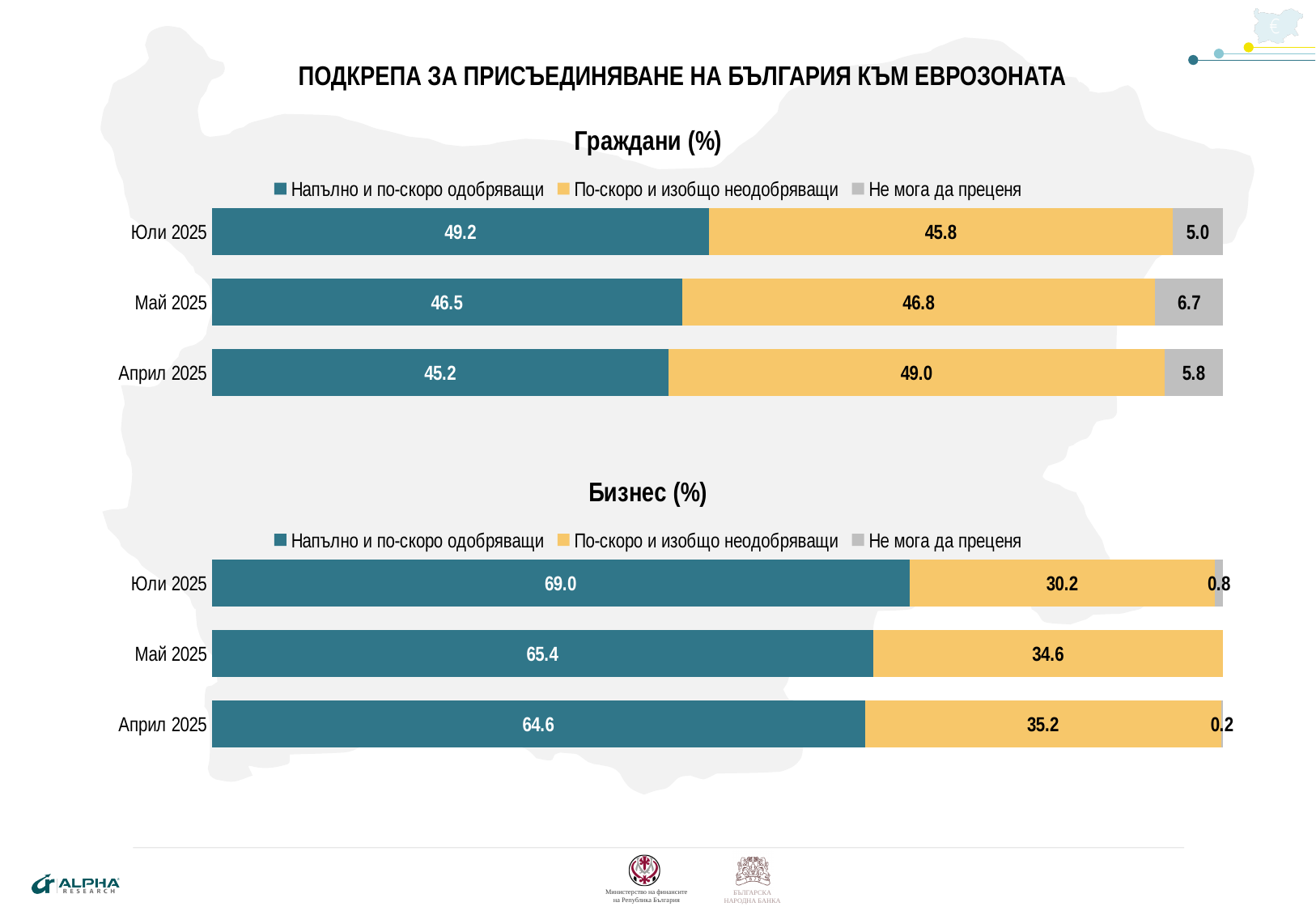
In the "Граждани (%)" chart, does the value for "Напълно и по-скоро одобряващи" rise or fall from Април 2025 to Юли 2025? Rise How many periods are shown in the "Бизнес (%)" chart? 3 In the "Граждани (%)" chart, what is the value for "Напълно и по-скоро одобряващи" in Юли 2025? 49.2 In the "Граждани (%)" chart, which period has the highest value for "По-скоро и изобщо неодобряващи"? Април 2025 How many series does the legend of the "Граждани (%)" chart list? 3 In the "Бизнес (%)" chart, what is the difference between the "Напълно и по-скоро одобряващи" values for Юли 2025 and Април 2025? 4.4 In the "Бизнес (%)" chart, which period has the lowest value for "Напълно и по-скоро одобряващи"? Април 2025 In the "Граждани (%)" chart, what is the value for "Не мога да преценя" in Май 2025? 6.7 In the "Бизнес (%)" chart, what is the value for "Напълно и по-скоро одобряващи" in Май 2025? 65.4 In the "Бизнес (%)" chart, what is the value for "По-скоро и изобщо неодобряващи" in Април 2025? 35.2 In the "Граждани (%)" chart, which is larger in Май 2025: "Напълно и по-скоро одобряващи" or "По-скоро и изобщо неодобряващи"? По-скоро и изобщо неодобряващи What kind of chart is the "Бизнес (%)" chart? Stacked bar chart